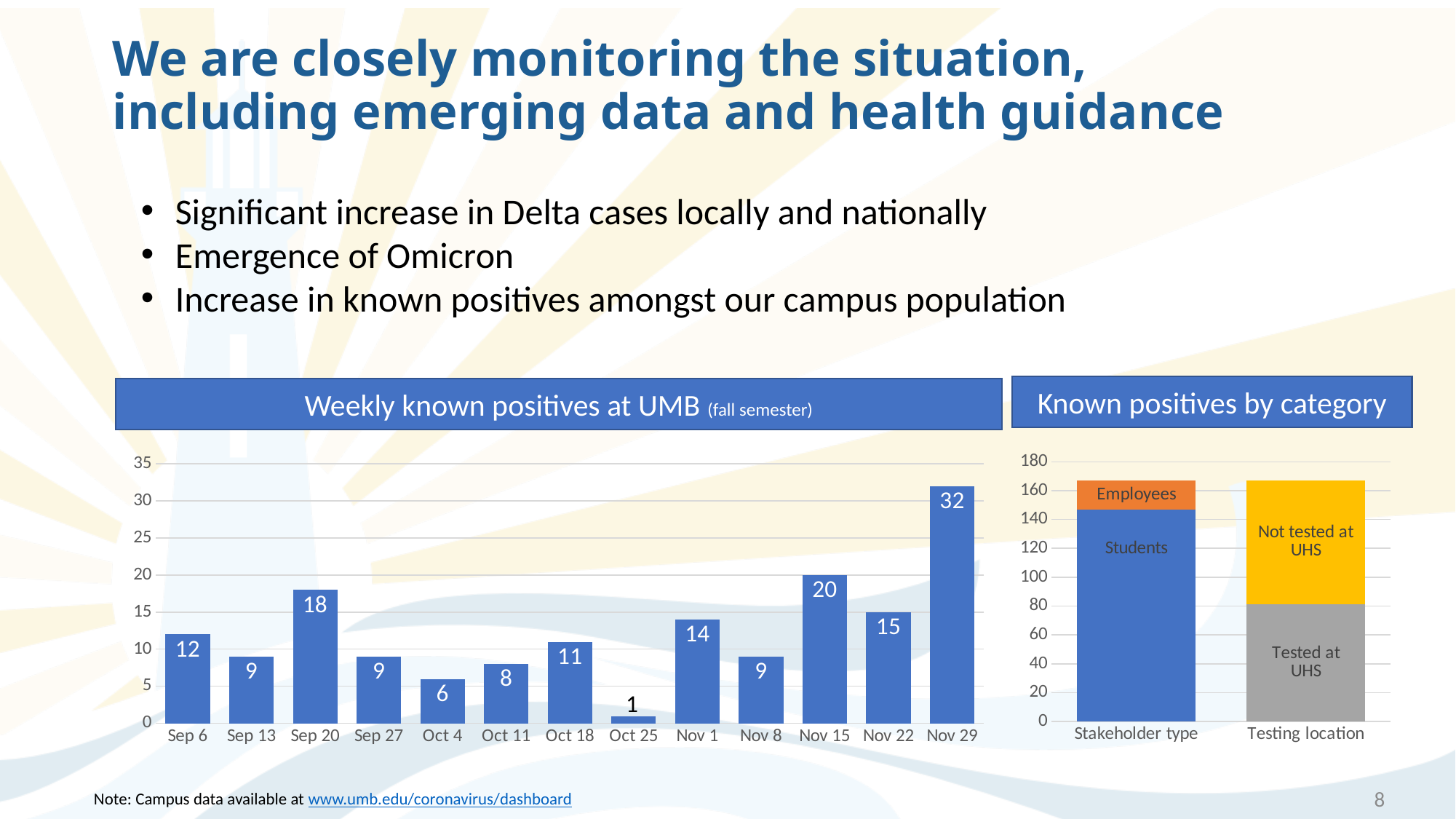
In the 'Weekly known positives at UMB' chart, what is the value for Oct 25? 1 How many weeks are shown in the 'Weekly known positives at UMB' chart? 13 In the 'Weekly known positives at UMB' chart, which week has the lowest value? Oct 25 In the 'Weekly known positives at UMB' chart, what is the difference between the values for Nov 29 and Nov 22? 17 In the 'Weekly known positives at UMB' chart, what is the value for Nov 29? 32 What kind of chart is the 'Weekly known positives at UMB' chart? bar chart In the 'Known positives by category' chart, which two segments make up the Testing location bar? Not tested at UHS and Tested at UHS In the 'Known positives by category' chart, is the Students segment of the Stakeholder type bar greater or less than 120? greater In the 'Weekly known positives at UMB' chart, which is larger, the value for Nov 15 or the value for Nov 1? Nov 15 In the 'Known positives by category' chart, is the Tested at UHS segment of the Testing location bar greater or less than 100? less In the 'Weekly known positives at UMB' chart, which week has the highest value? Nov 29 In the 'Weekly known positives at UMB' chart, what is the value for Sep 20? 18